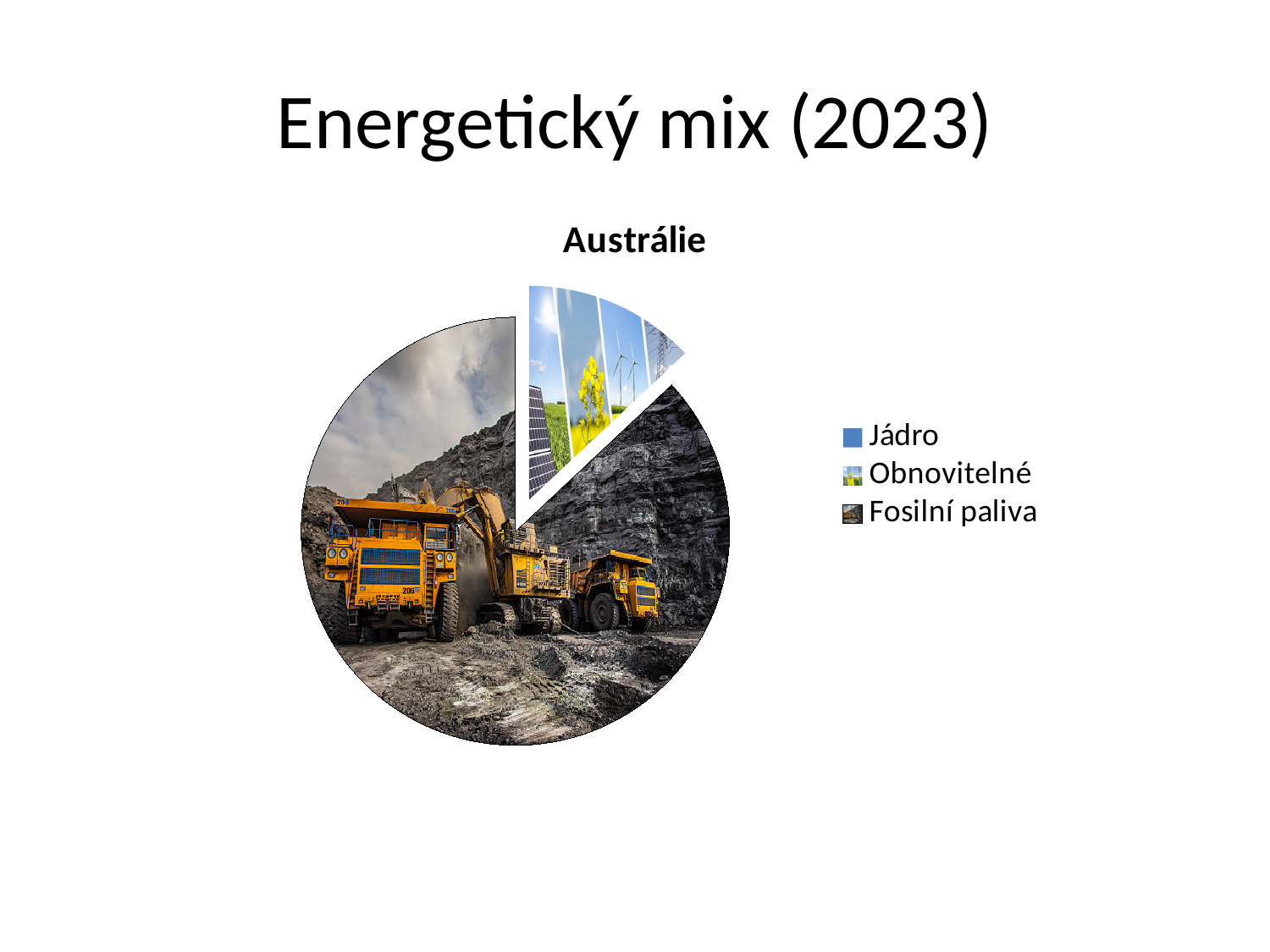
Which category has the largest slice in the pie chart? Fosilní paliva Which slice is larger in the pie chart, Fosilní paliva or Obnovitelné? Fosilní paliva Which slice of the pie chart is pulled out (exploded) from the rest? Obnovitelné What is the title of the pie chart? Austrálie What kind of chart is shown on the slide? pie chart Which legend entry is listed first in the pie chart's legend? Jádro How many entries does the legend of the pie chart list? 3